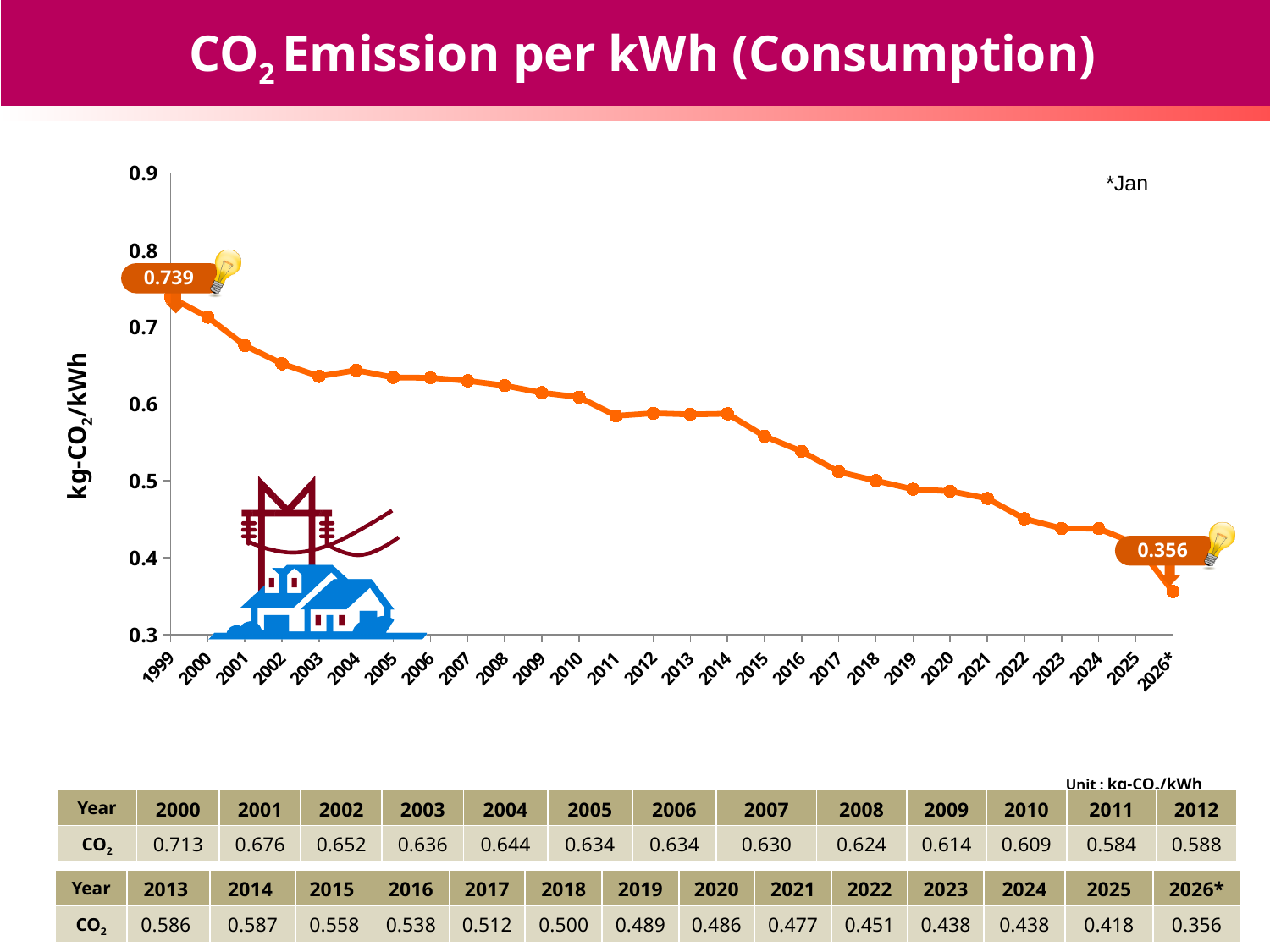
Which year has the highest CO2 emission per kWh? 1999 Which year has a larger CO2 emission per kWh value, 2005 or 2015? 2005 What is the difference between the CO2 emission per kWh values for 1999 and 2026*? 0.383 What is the CO2 emission per kWh value for 2014? 0.587 What type of chart is shown on the slide? line chart Is the CO2 emission per kWh value for 2010 greater or less than 0.6? greater What is the CO2 emission per kWh value for 2026*? 0.356 What is the CO2 emission per kWh value for 1999? 0.739 What is the CO2 emission per kWh value for 2020? 0.486 Do the CO2 emission per kWh values generally rise or fall from 1999 to 2026*? fall Which year has the lowest CO2 emission per kWh? 2026* What is the label on the vertical axis of the chart? kg-CO2/kWh